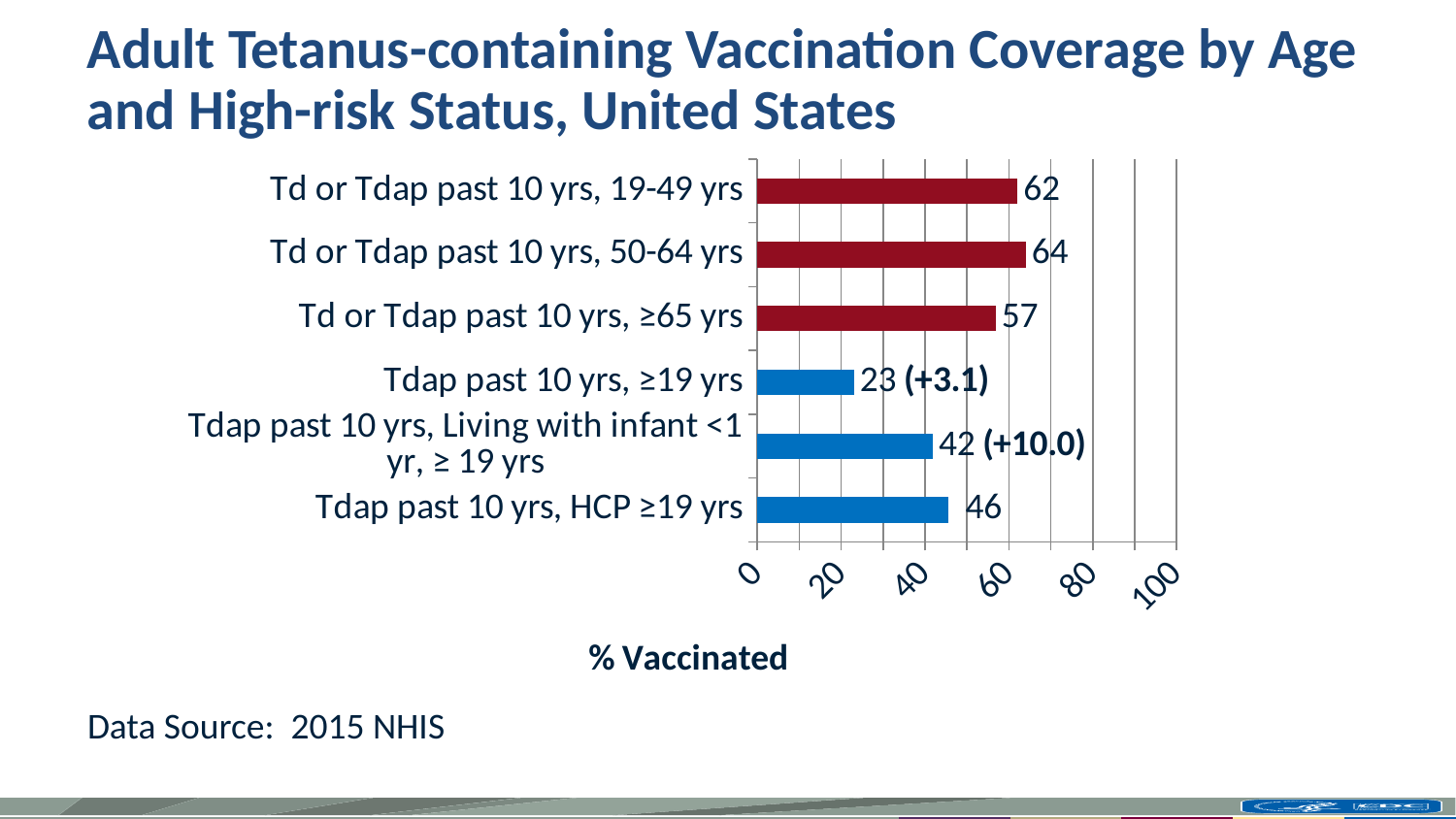
Which category has the lowest value? Tdap past 10 yrs, ≥19 yrs What is the value for Td or Tdap past 10 yrs, 19-49 yrs? 62 What is the value for Tdap past 10 yrs, ≥19 yrs? 23 What is the label of the horizontal axis? % Vaccinated Is the value for Td or Tdap past 10 yrs, 19-49 yrs greater or less than 60? greater What kind of chart is shown on the slide? bar chart How many categories are shown in the chart? 6 What is the difference between the values for Td or Tdap past 10 yrs, 50-64 yrs and Td or Tdap past 10 yrs, ≥65 yrs? 7 What is the value for Tdap past 10 yrs, HCP ≥19 yrs? 46 Which is larger: the value for Tdap past 10 yrs, HCP ≥19 yrs or the value for Tdap past 10 yrs, Living with infant <1 yr, ≥ 19 yrs? Tdap past 10 yrs, HCP ≥19 yrs Which category has the highest value? Td or Tdap past 10 yrs, 50-64 yrs What is the value for Td or Tdap past 10 yrs, ≥65 yrs? 57